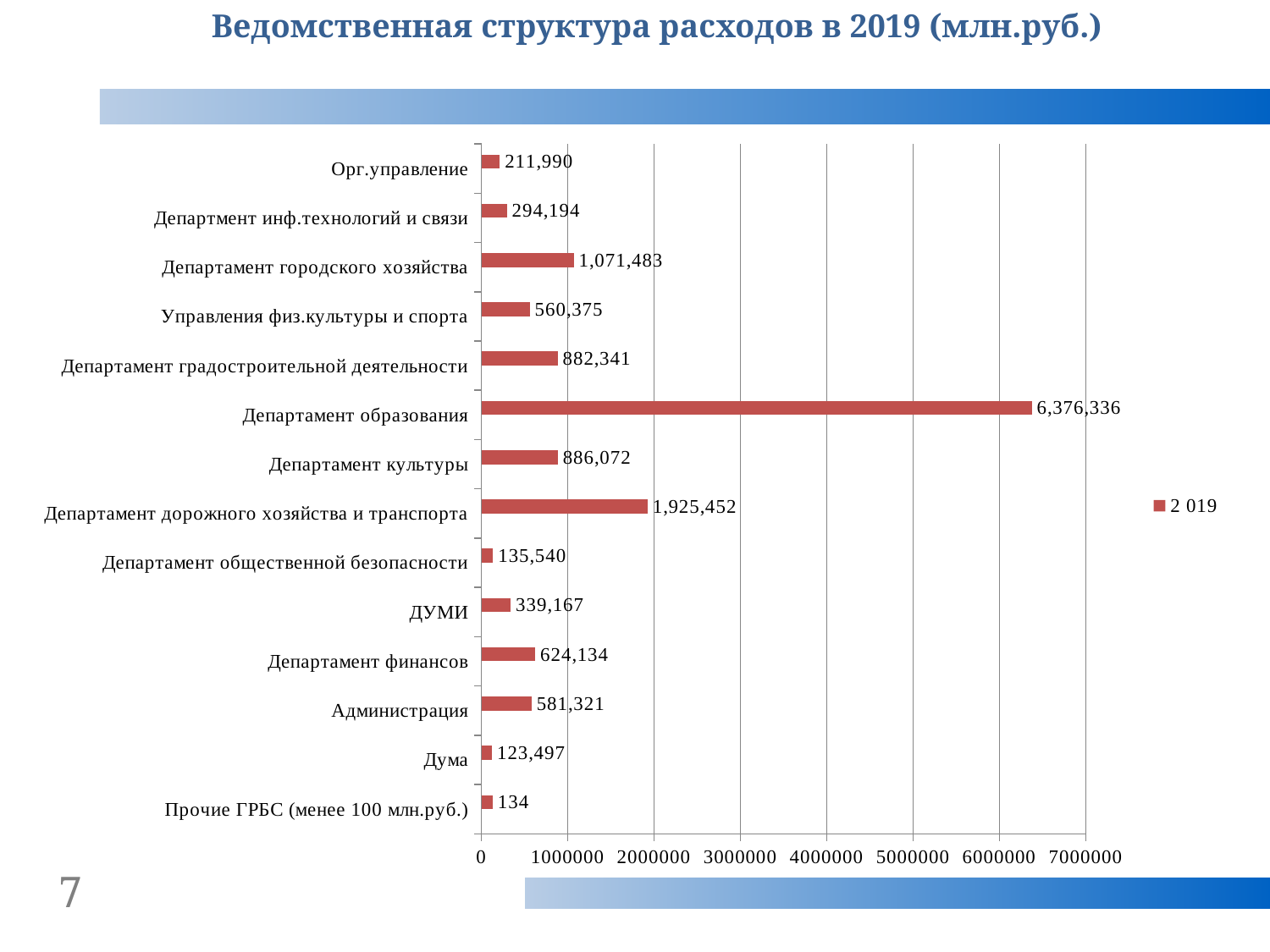
What is the value for Департамент образования? 6,376,336 What is the difference between the values for Департамент дорожного хозяйства и транспорта and Департамент городского хозяйства? 853,969 How many categories are shown on the chart? 14 Which is larger, the value for Департамент финансов or the value for Администрация? Департамент финансов How many series does the legend list? 1 Is the value for Департамент образования greater or less than 6000000? greater What is the value for Департамент дорожного хозяйства и транспорта? 1,925,452 What is the value for Дума? 123,497 Which category has the highest value? Департамент образования What kind of chart is shown on the slide? bar chart What is the value for ДУМИ? 339,167